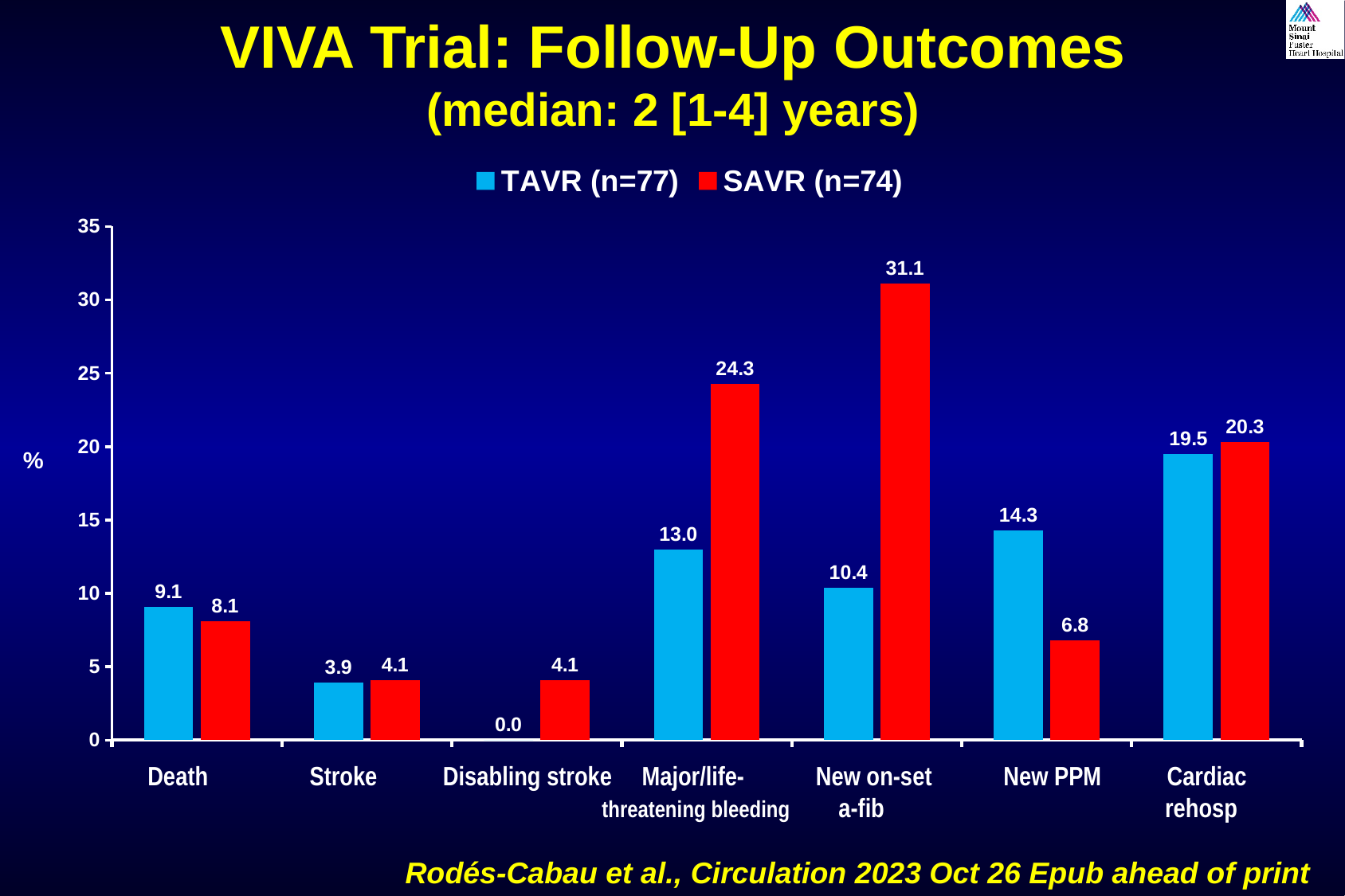
What kind of chart is shown on the slide? Bar chart What colour represents the SAVR series? Red What is the SAVR value for Major/life-threatening bleeding? 24.3 What is the SAVR value for New on-set a-fib? 31.1 How many outcome categories are shown on the x axis? 7 Which is larger for Cardiac rehosp, the TAVR value or the SAVR value? SAVR What is the TAVR value for Disabling stroke? 0.0 What is the difference between the SAVR and TAVR values for New PPM? 7.5 What is the TAVR value for Death? 9.1 How many series does the legend list? 2 Which category has the highest SAVR value? New on-set a-fib Which category has the lowest TAVR value? Disabling stroke